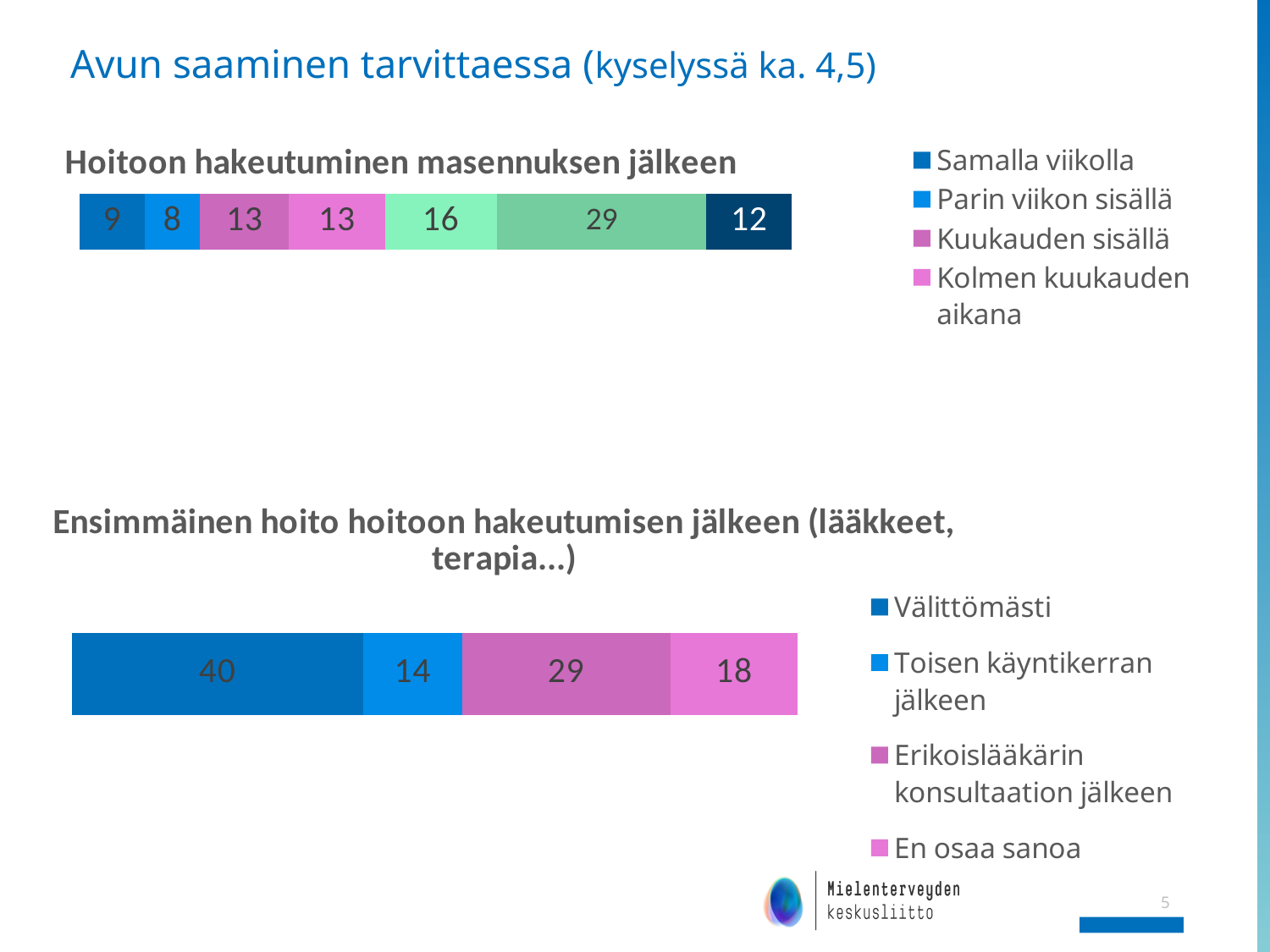
What kind of chart is the chart titled "Hoitoon hakeutuminen masennuksen jälkeen"? Stacked bar chart In the chart titled "Ensimmäinen hoito hoitoon hakeutumisen jälkeen (lääkkeet, terapia...)", how many series does the legend list? 4 In the chart titled "Ensimmäinen hoito hoitoon hakeutumisen jälkeen (lääkkeet, terapia...)", which series has the smallest value? Toisen käyntikerran jälkeen In the chart titled "Hoitoon hakeutuminen masennuksen jälkeen", how many segments does the stacked bar contain? 7 In the chart titled "Ensimmäinen hoito hoitoon hakeutumisen jälkeen (lääkkeet, terapia...)", what is the value for "Erikoislääkärin konsultaation jälkeen"? 29 In the chart titled "Ensimmäinen hoito hoitoon hakeutumisen jälkeen (lääkkeet, terapia...)", what is the value for "Välittömästi"? 40 In the chart titled "Hoitoon hakeutuminen masennuksen jälkeen", which is larger, the value for "Samalla viikolla" or the value for "Parin viikon sisällä"? Samalla viikolla In the chart titled "Ensimmäinen hoito hoitoon hakeutumisen jälkeen (lääkkeet, terapia...)", what is the difference between the values for "Välittömästi" and "Toisen käyntikerran jälkeen"? 26 In the chart titled "Ensimmäinen hoito hoitoon hakeutumisen jälkeen (lääkkeet, terapia...)", which series has the largest value? Välittömästi In the chart titled "Hoitoon hakeutuminen masennuksen jälkeen", what is the value for "Samalla viikolla"? 9 In the chart titled "Hoitoon hakeutuminen masennuksen jälkeen", what is the value for "Parin viikon sisällä"? 8 In the chart titled "Ensimmäinen hoito hoitoon hakeutumisen jälkeen (lääkkeet, terapia...)", what is the value for "En osaa sanoa"? 18